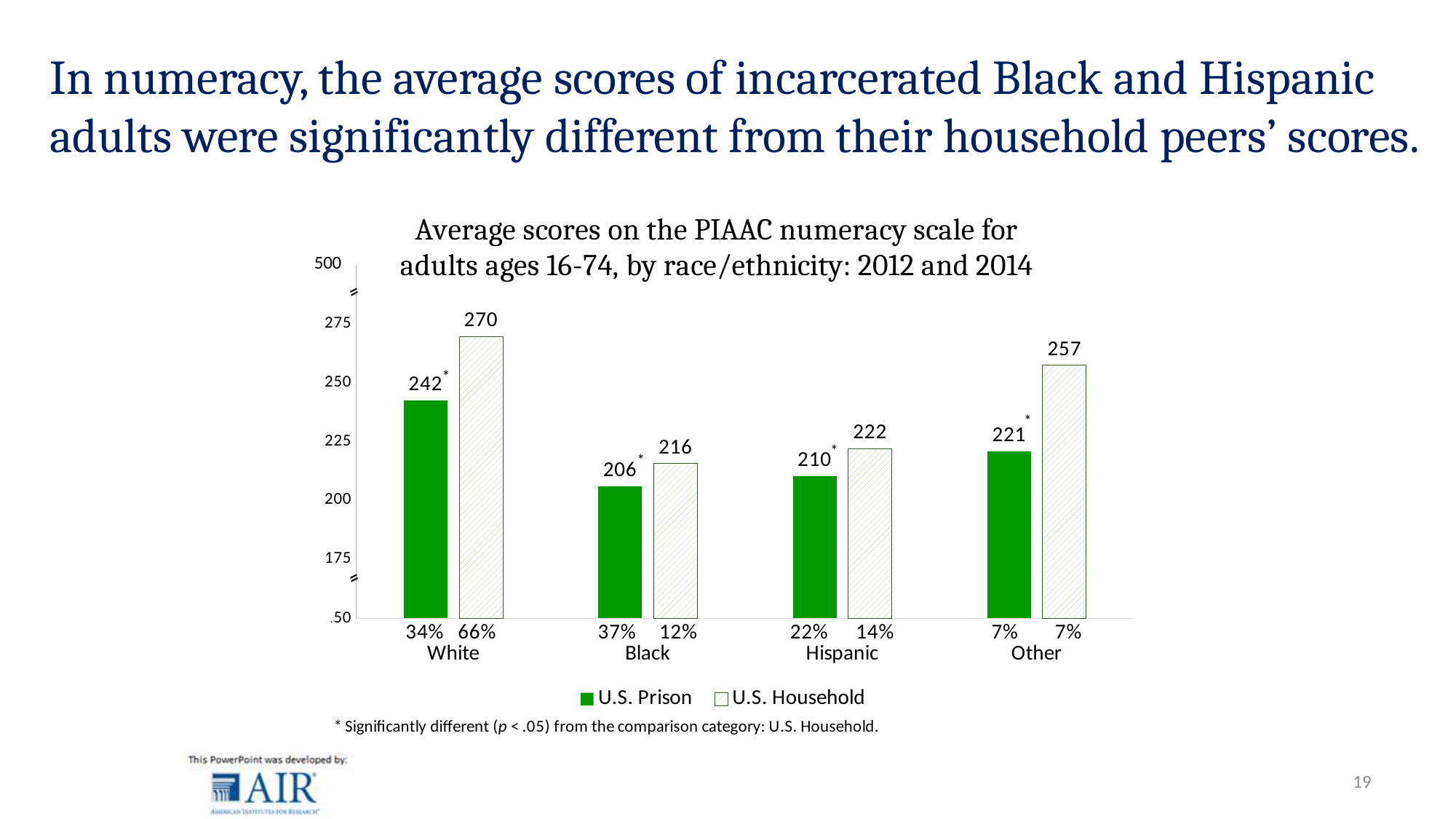
Which race/ethnicity category has the lowest U.S. Prison score? Black Which is larger, the U.S. Prison score for White adults or the U.S. Household score for Other adults? U.S. Household score for Other adults How many race/ethnicity categories are shown on the x axis? 4 What is the average numeracy score for U.S. Household adults in the Other category? 257 What is the difference between the U.S. Household and U.S. Prison scores for Hispanic adults? 12 How many series does the legend list? 2 What is the average numeracy score for U.S. Prison adults in the White category? 242 What is the difference between the U.S. Household and U.S. Prison scores for Other adults? 36 What is the average numeracy score for U.S. Household adults in the Black category? 216 Which race/ethnicity category has the highest U.S. Household score? White What kind of chart is shown on the slide? Bar chart What percentage is printed below the U.S. Prison bar for the Black category? 37%